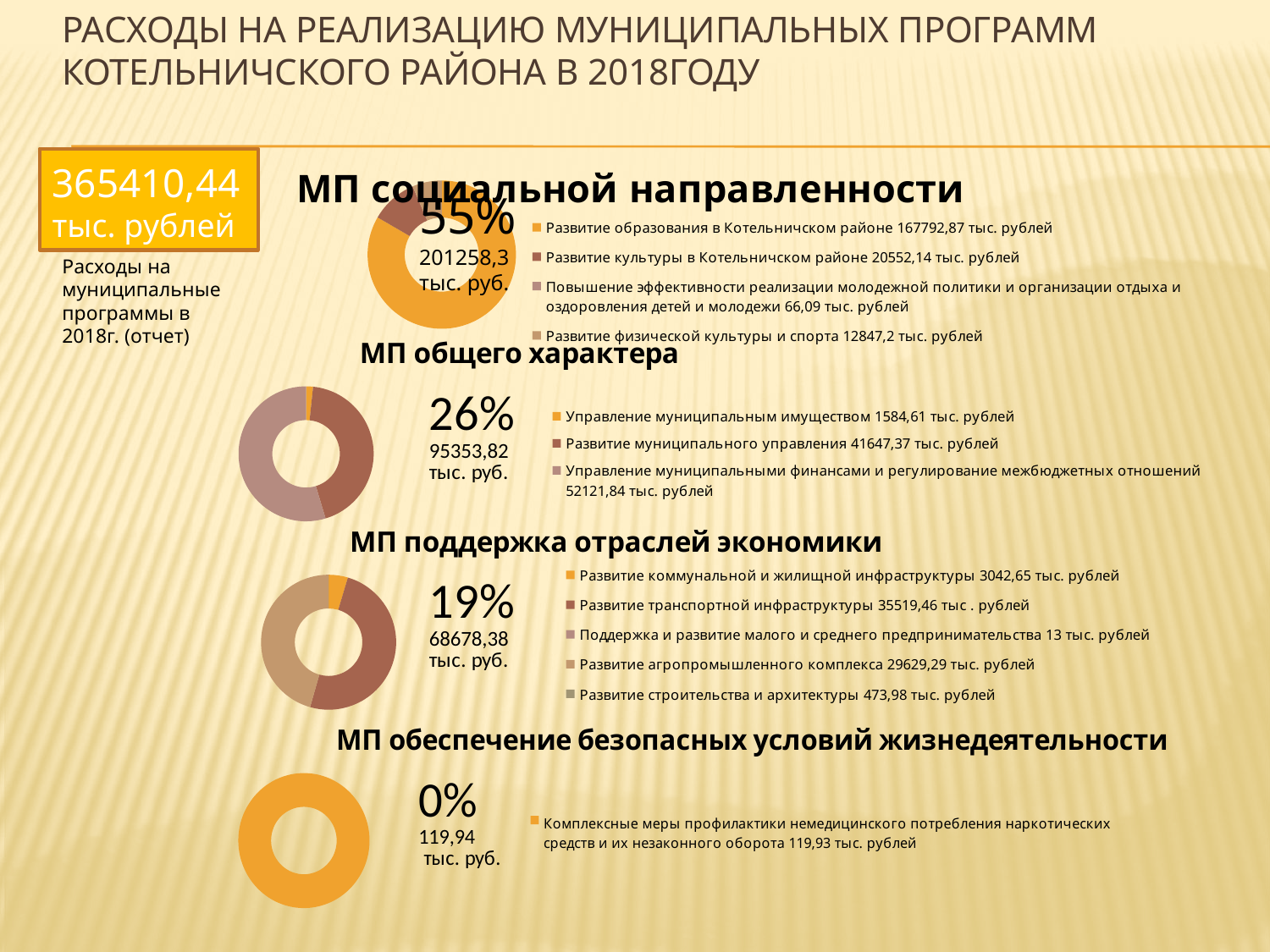
How many entries does the legend of the "МП социальной направленности" chart list? 4 In the "МП общего характера" chart, what is the value for "Развитие муниципального управления"? 41647,37 тыс. рублей How many entries does the legend of the "МП поддержка отраслей экономики" chart list? 5 Which legend entry has the smallest value in the "МП социальной направленности" chart? Повышение эффективности реализации молодежной политики и организации отдыха и оздоровления детей и молодежи What kind of chart is used for "МП общего характера"? Donut (pie) chart In the "МП социальной направленности" chart, what is the value for "Развитие образования в Котельничском районе"? 167792,87 тыс. рублей In the "МП общего характера" chart, what is the difference between "Управление муниципальными финансами и регулирование межбюджетных отношений" and "Развитие муниципального управления"? 10474,47 тыс. рублей What share of total expenditure is shown for "МП социальной направленности"? 55% In the "МП поддержка отраслей экономики" chart, what is the value for "Развитие агропромышленного комплекса"? 29629,29 тыс. рублей Which legend entry has the largest value in the "МП поддержка отраслей экономики" chart? Развитие транспортной инфраструктуры In the "МП поддержка отраслей экономики" chart, which is larger: "Развитие коммунальной и жилищной инфраструктуры" or "Развитие строительства и архитектуры"? Развитие коммунальной и жилищной инфраструктуры What total amount is shown next to the "МП обеспечение безопасных условий жизнедеятельности" chart? 119,94 тыс. руб.